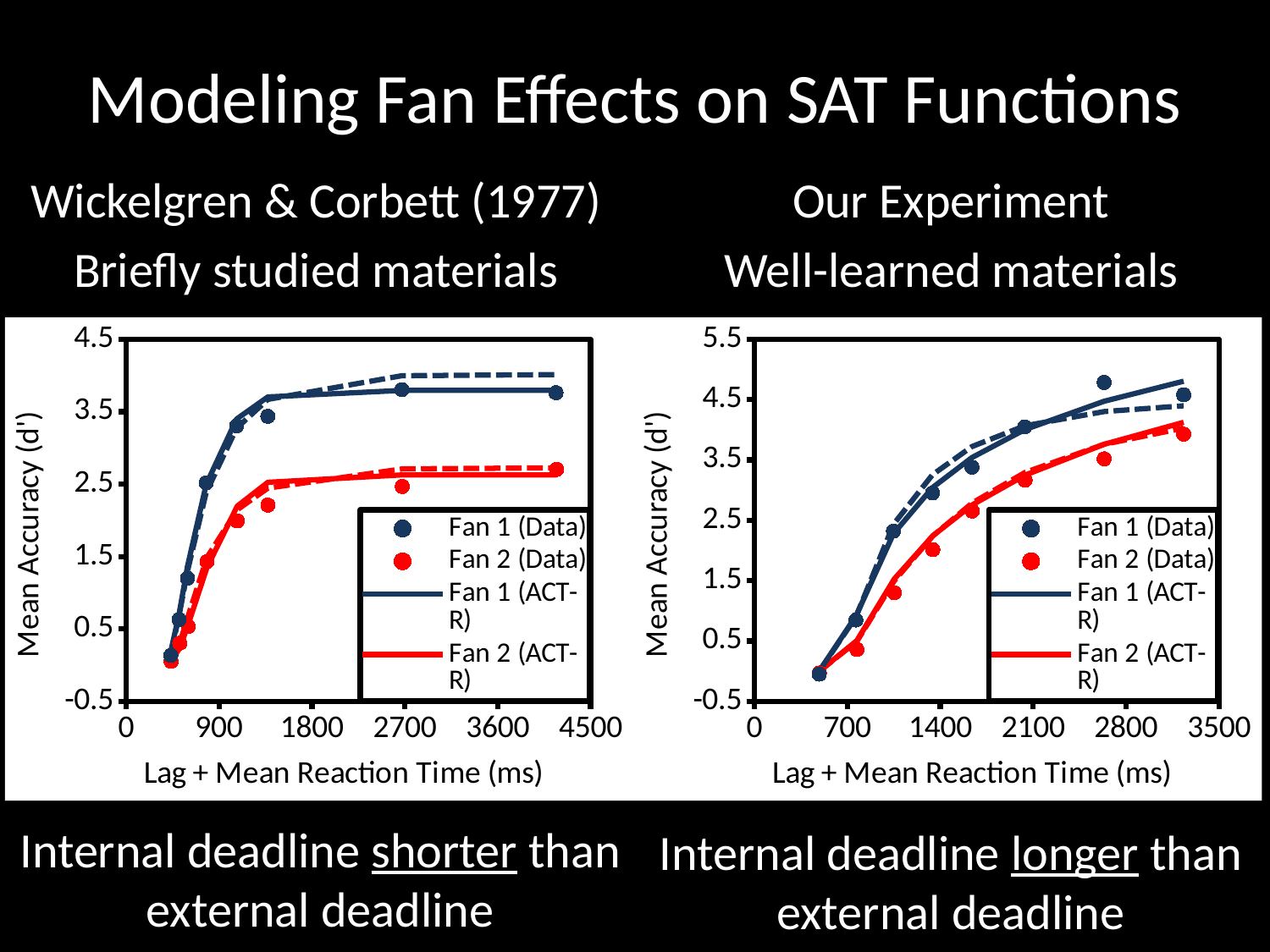
In the right chart, is the Fan 1 (Data) value at about 2650 ms greater or less than 4.5? greater In the left chart (Wickelgren & Corbett), how many entries does the legend list? 4 In the left chart, at the rightmost data points, which series has the higher Mean Accuracy: Fan 1 (Data) or Fan 2 (Data)? Fan 1 (Data) In the right chart, what is the label of the y axis? Mean Accuracy (d') In the left chart, is the Fan 1 (Data) value at about 2700 ms greater or less than 3.5? greater In the right chart, is the Fan 1 (Data) value at about 1050 ms greater or less than 2.5? less In the left chart, do the Fan 1 (Data) values rise or fall as Lag + Mean Reaction Time increases? rise In the left chart, what is the label of the x axis? Lag + Mean Reaction Time (ms) In the right chart, do the Fan 2 (Data) values rise or fall as Lag + Mean Reaction Time increases? rise In the right chart (Our Experiment), how many entries does the legend list? 4